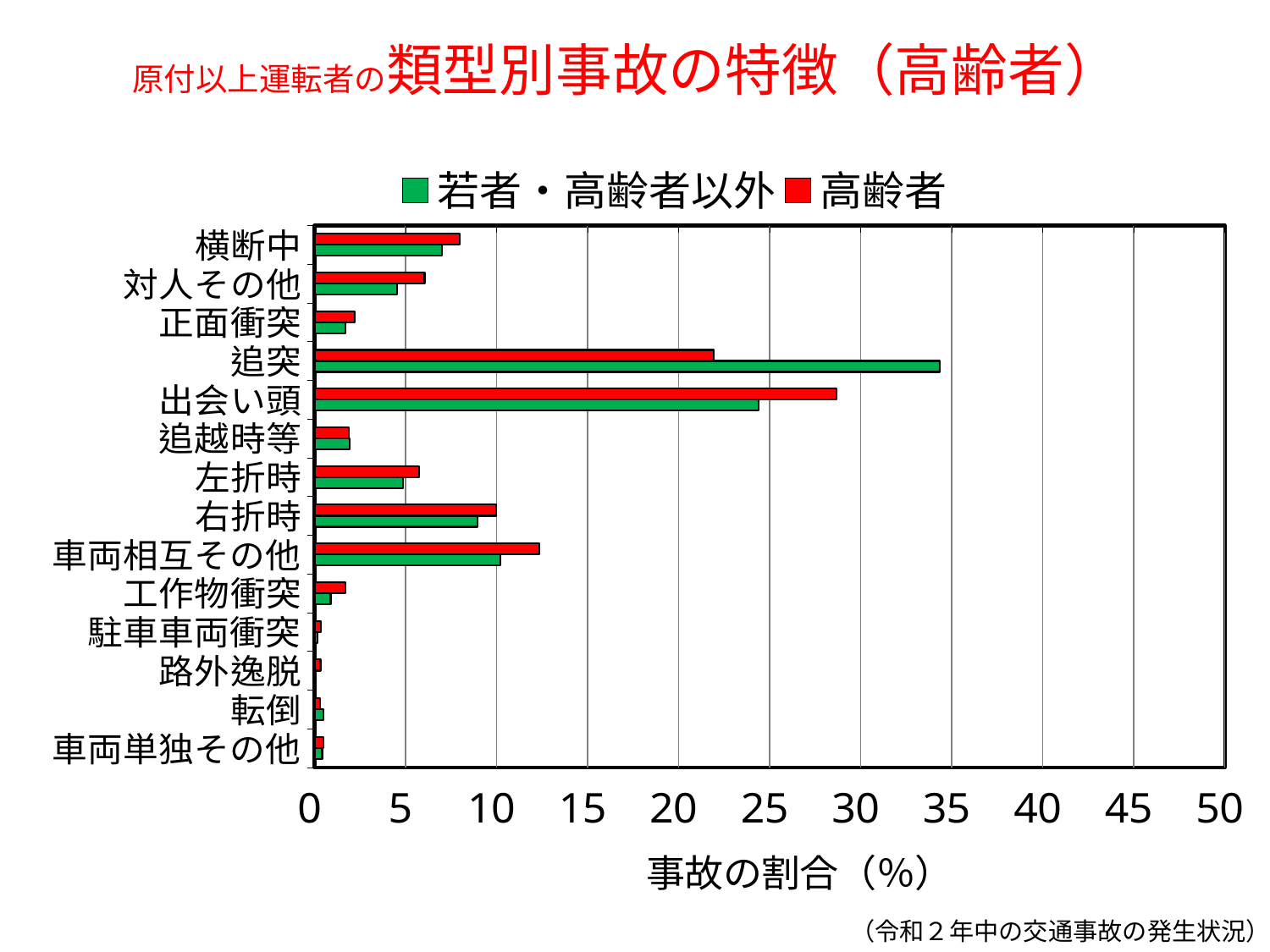
Is the 高齢者 value for 横断中 greater or less than 10? less How many series does the legend list? 2 What is the label of the horizontal axis? 事故の割合（%） What kind of chart is shown on the slide? bar chart For 車両相互その他, which series has the larger value, 若者・高齢者以外 or 高齢者? 高齢者 Which category has the highest value for the 若者・高齢者以外 series? 追突 Which category has the highest value for the 高齢者 series? 出会い頭 Is the 若者・高齢者以外 value for 追突 greater or less than 30? greater How many accident-type categories are shown on the vertical axis? 14 For 出会い頭, which series has the larger value, 若者・高齢者以外 or 高齢者? 高齢者 Is the 高齢者 value for 出会い頭 greater or less than 25? greater For 追突, which series has the larger value, 若者・高齢者以外 or 高齢者? 若者・高齢者以外